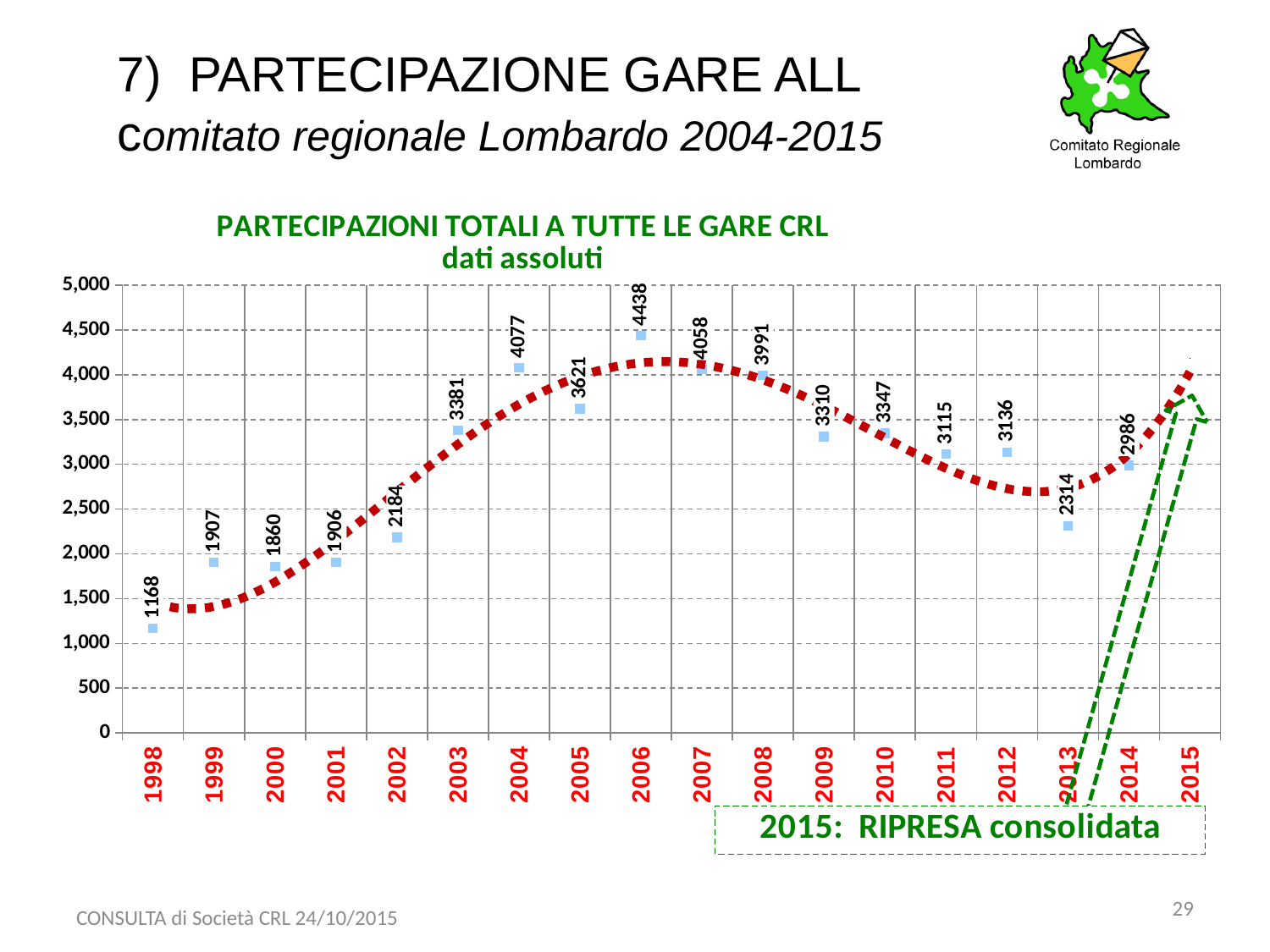
How many years are shown on the x axis of the chart? 18 Do the values rise or fall from 2006 to 2013? fall Is the value for 2015 greater or less than 3,500? greater What is the difference between the values for 2014 and 2013? 672 What is the title of the chart? PARTECIPAZIONI TOTALI A TUTTE LE GARE CRL dati assoluti Which year has the lowest value in the chart? 1998 What is the value for 1998 in the chart? 1168 Which year has the highest value in the chart? 2006 What is the value for 2006 in the chart? 4438 What is the value for 2013 in the chart? 2314 Which is larger, the value for 2004 or the value for 2007? 2004 What is the difference between the values for 2006 and 2013? 2124